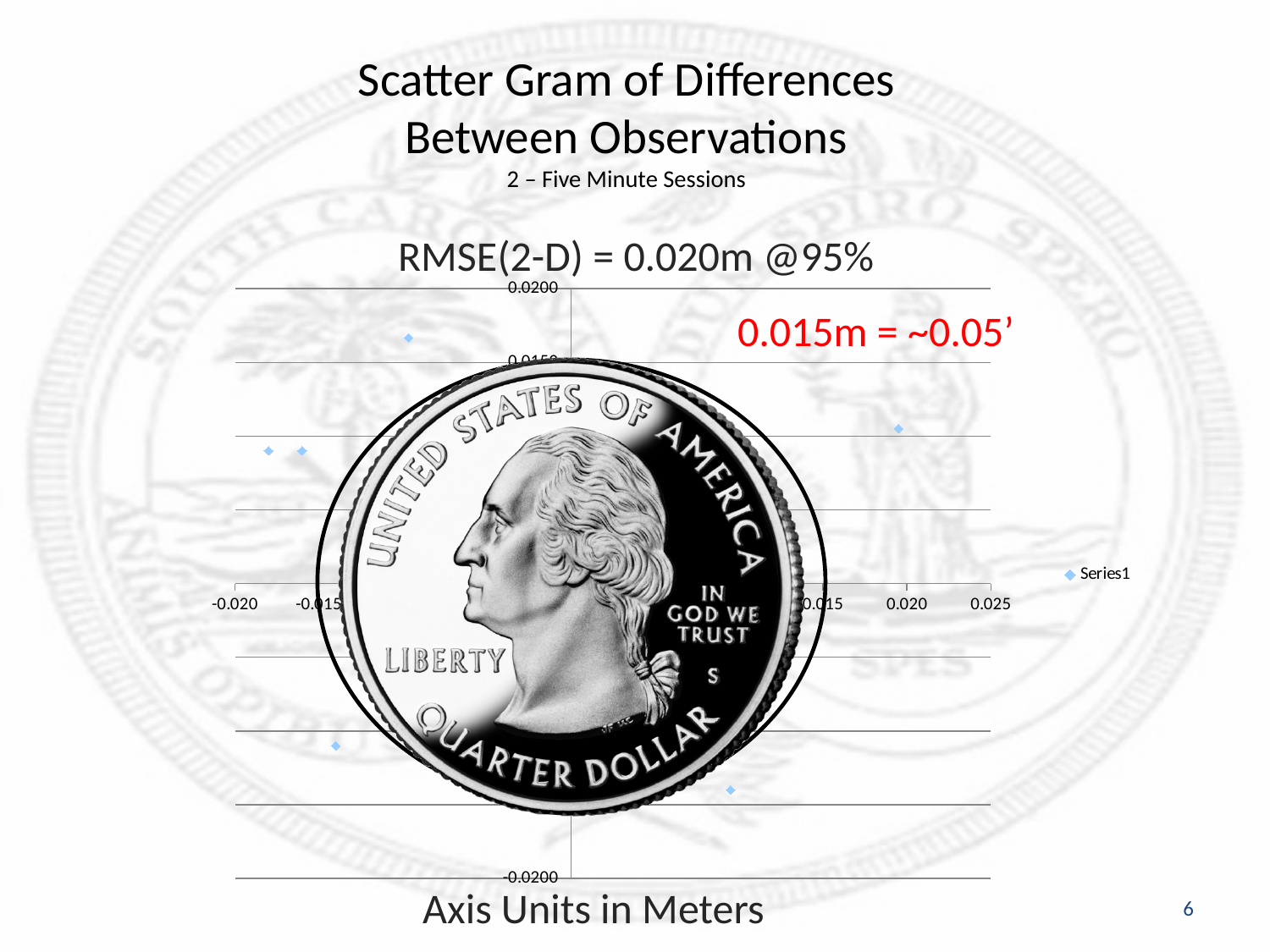
What is the name of the series shown in the chart's legend? Series1 What is the title of the chart? RMSE(2-D) = 0.020m @95% Is the lowest plotted point on the chart greater or less than -0.0200 on the vertical axis? greater How many series does the chart's legend list? 1 What kind of chart is shown on the slide? scatter chart Is the highest plotted point on the chart above or below 0.0150 on the vertical axis? above